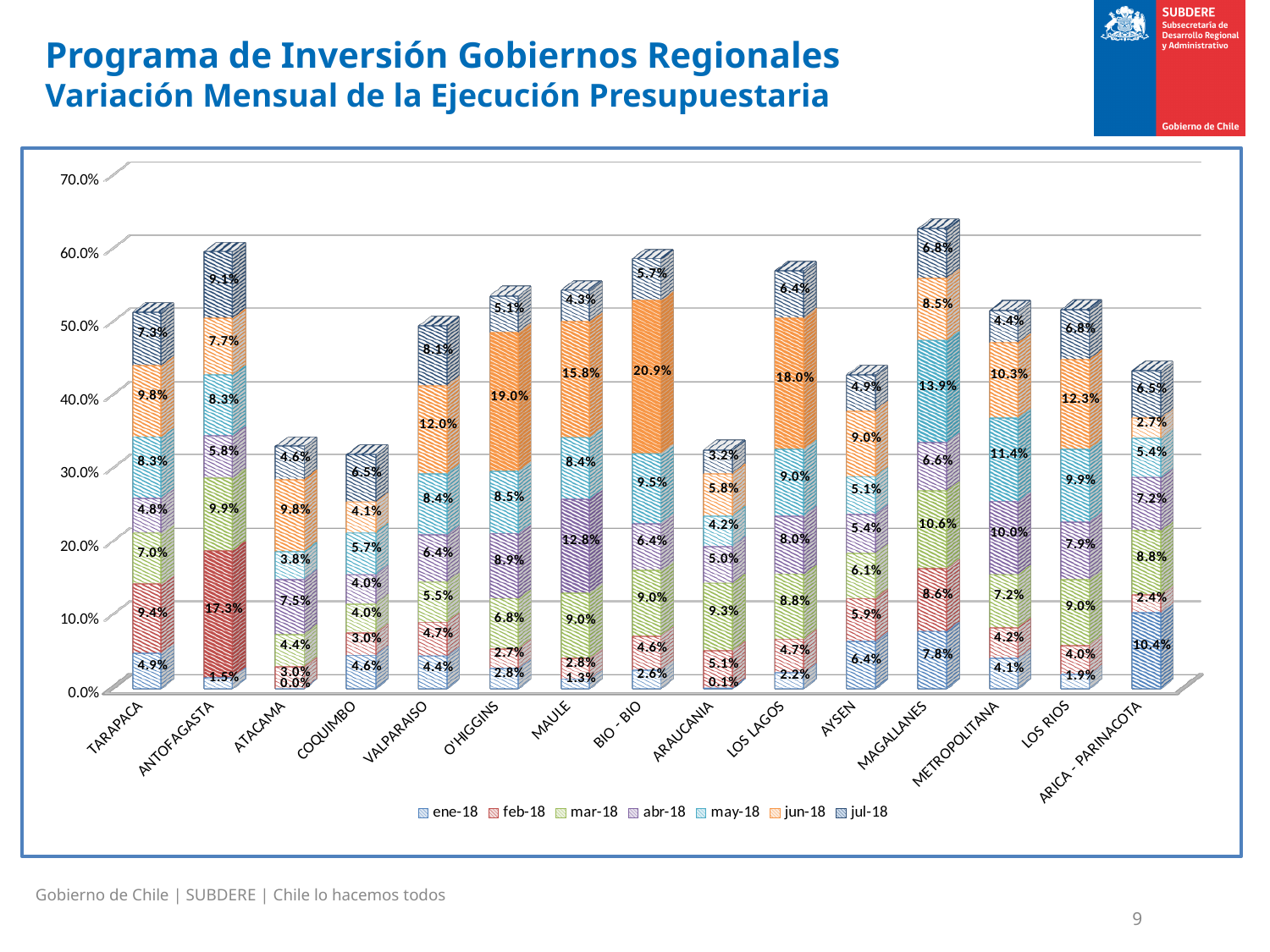
What is the ene-18 value for ARICA - PARINACOTA? 10.4% What is the total of the stacked bar for COQUIMBO? 31.9% What is the may-18 value for MAGALLANES? 13.9% What is the jun-18 value for BIO - BIO? 20.9% Which region has the highest jun-18 value? BIO - BIO What is the feb-18 value for ANTOFAGASTA? 17.3% Which is larger, the abr-18 value for MAULE or the abr-18 value for METROPOLITANA? MAULE Which region has the lowest ene-18 value? ATACAMA Is the total stacked value for MAGALLANES greater or less than 60.0%? greater How many series does the legend list? 7 What is the difference between the jun-18 values for BIO - BIO and LOS LAGOS? 2.9% How many regions are shown on the x axis? 15